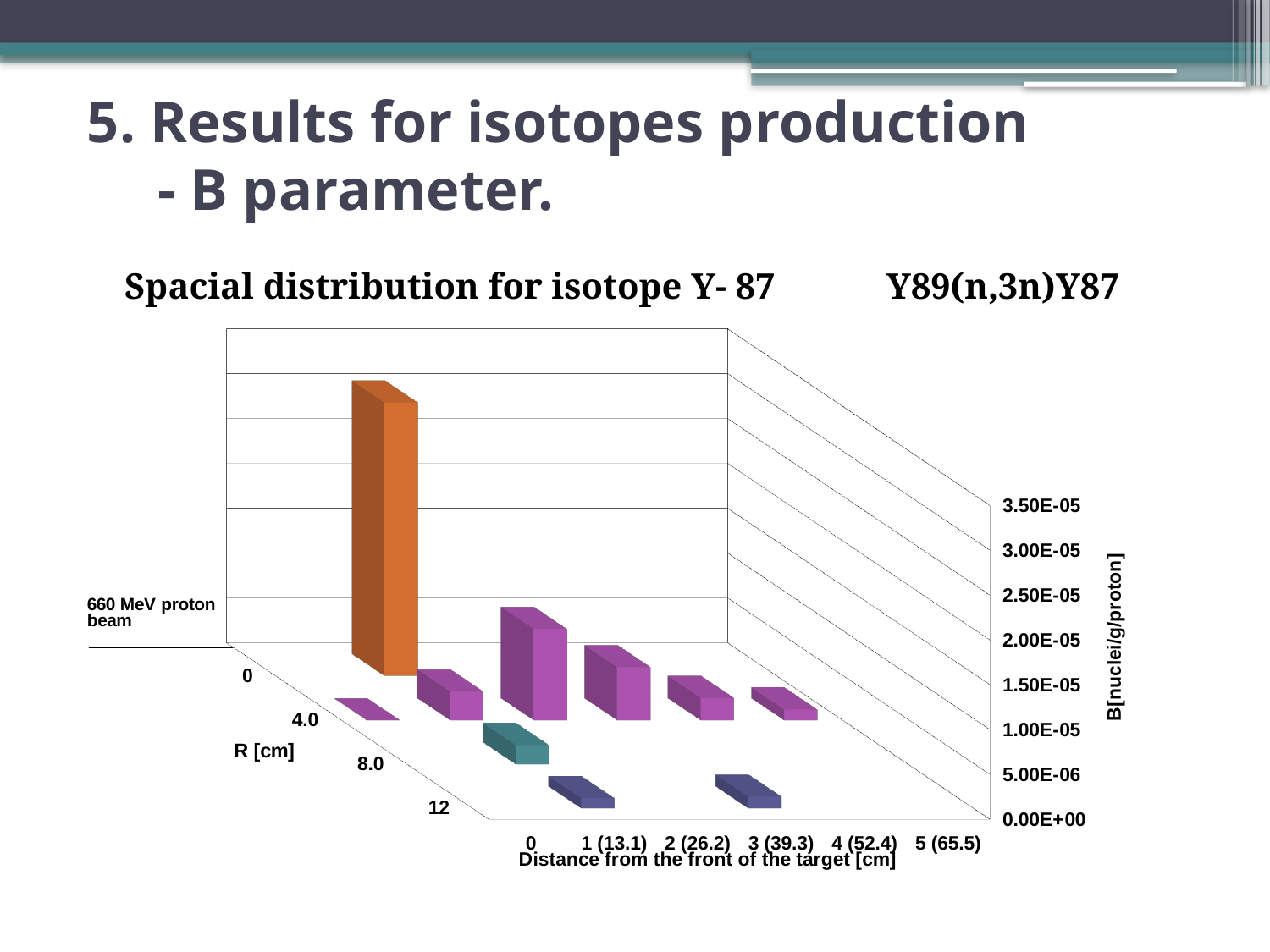
How many distance categories are shown along the 'Distance from the front of the target [cm]' axis? 6 How many R [cm] values are shown on the depth axis? 4 What is the label of the vertical value axis? B[nuclei/g/proton] What is the maximum value shown on the B[nuclei/g/proton] axis? 3.50E-05 Is the value of the tallest bar (orange, at R = 0) greater or less than 1.00E-05? greater At which distance from the front of the target and which R value is the tallest bar located? Distance 1 (13.1), R = 0 What is the title of the chart? Spacial distribution for isotope Y- 87 What kind of chart is shown on the slide? 3D bar chart Among the bars at R = 4.0, which distance category has the highest bar? 2 (26.2) Is the value of the bar at R = 4.0, distance 5 (65.5) greater or less than 1.00E-05? less